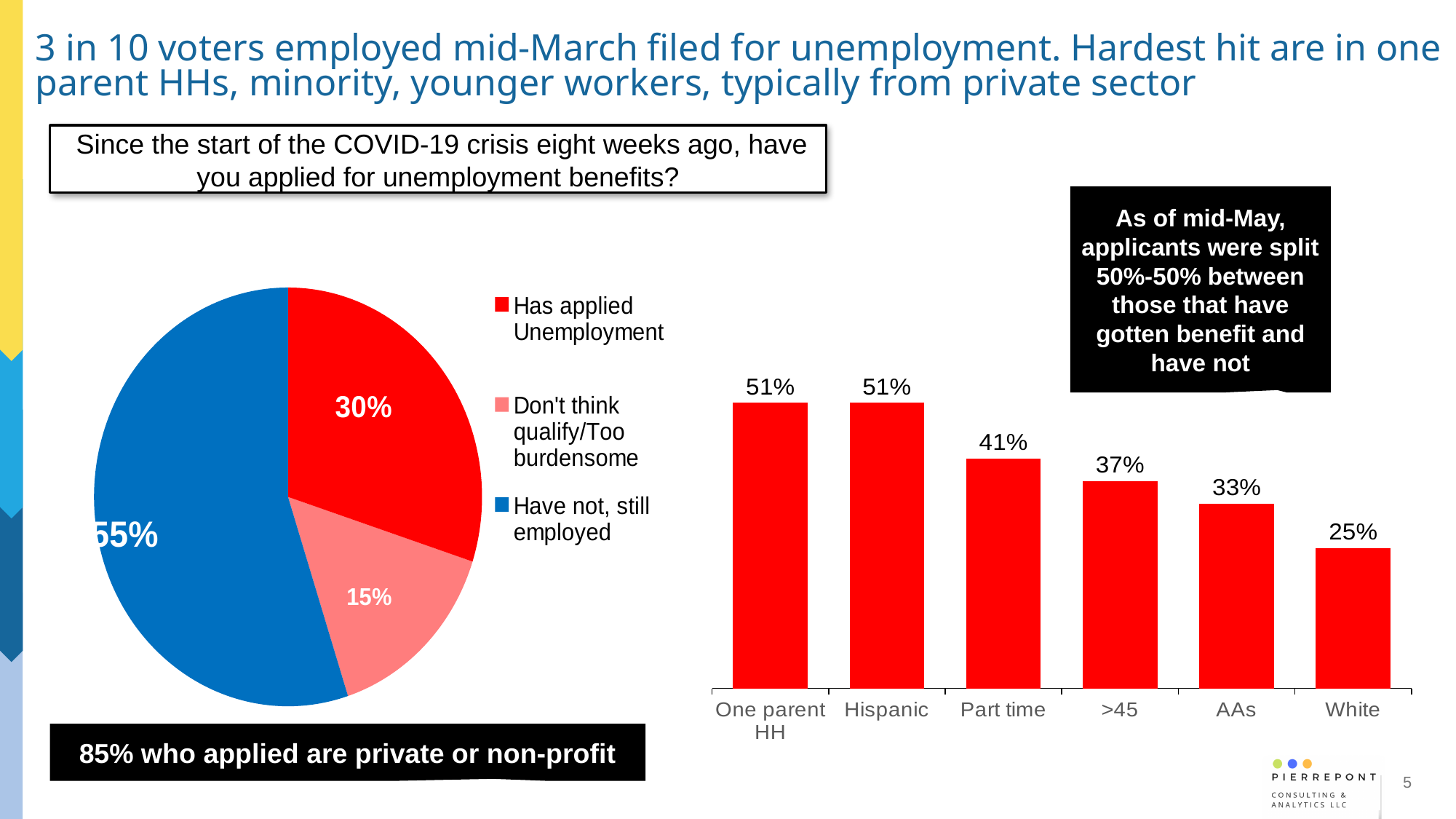
In the bar chart on the right, what is the value for Part time? 41% In the bar chart on the right, what is the value for AAs? 33% In the bar chart on the right, which category has the lowest value? White In the pie chart on the left, which category has the largest slice? Have not, still employed In the bar chart on the right, do the values rise or fall from left to right? fall In the pie chart on the left, how many entries does the legend list? 3 In the pie chart on the left, which category has the smallest slice? Don't think qualify/Too burdensome In the pie chart on the left, what share of respondents have not applied and are still employed? 55% In the pie chart on the left, what share of respondents don't think they qualify or find it too burdensome? 15% In the bar chart on the right, how many categories are shown? 6 In the bar chart on the right, what is the difference between the values for One parent HH and White? 26% In the pie chart on the left, what share of respondents has applied for unemployment? 30%